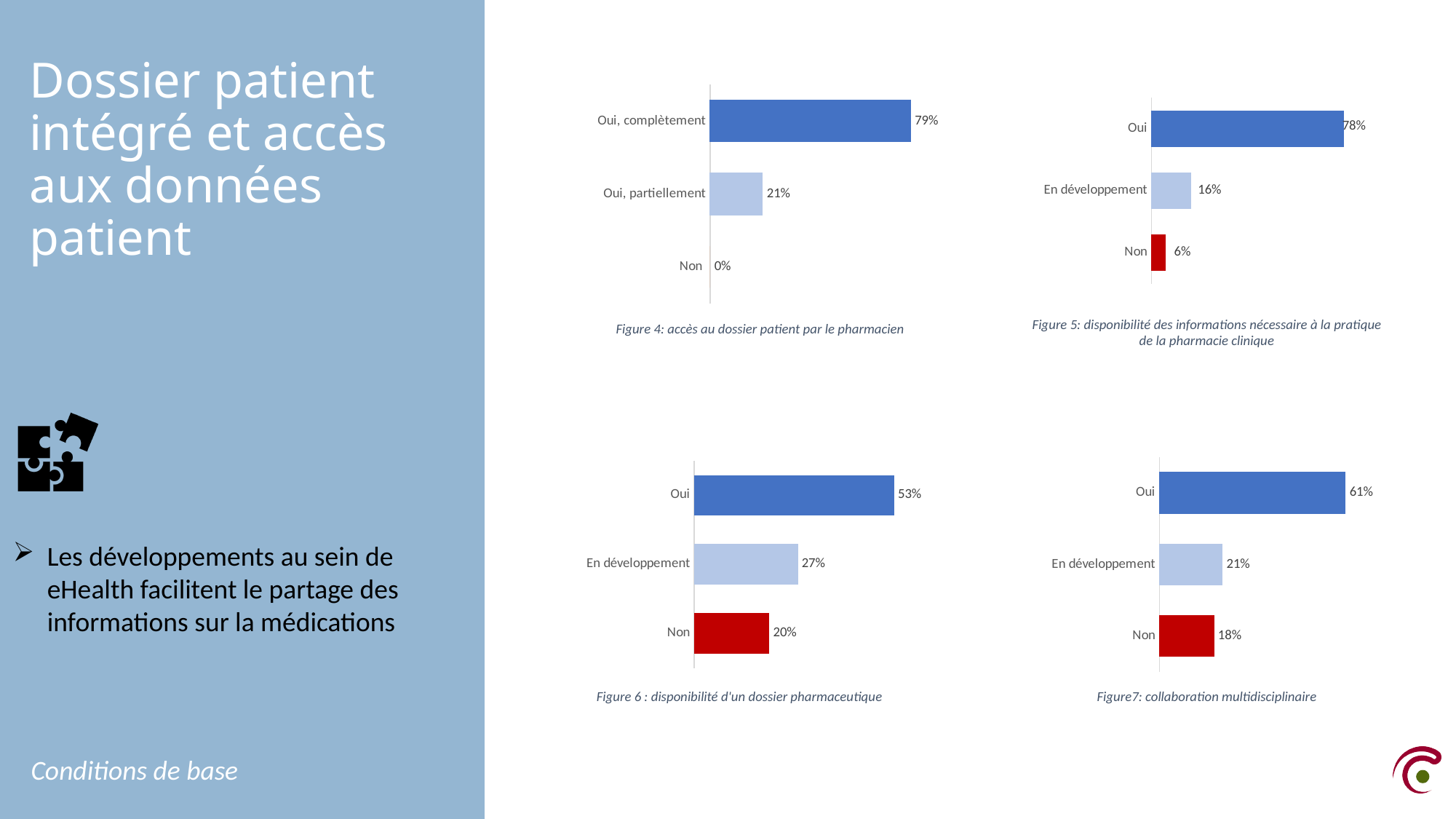
In Figure 6 (disponibilité d'un dossier pharmaceutique), what is the difference between "Oui" and "En développement"? 26% In Figure 5 (disponibilité des informations nécessaire à la pratique de la pharmacie clinique), which category has the lowest value? Non In Figure 4 (accès au dossier patient par le pharmacien), what is the value for "Non"? 0% What kind of chart is Figure 6 (disponibilité d'un dossier pharmaceutique)? Bar chart In Figure 7 (collaboration multidisciplinaire), which category has the highest value? Oui In Figure 4 (accès au dossier patient par le pharmacien), what is the value for "Oui, complètement"? 79% In Figure 6 (disponibilité d'un dossier pharmaceutique), what is the value for "Non"? 20% In Figure 7 (collaboration multidisciplinaire), which is larger, "En développement" or "Non"? En développement In Figure 5 (disponibilité des informations nécessaire à la pratique de la pharmacie clinique), what is the value for "En développement"? 16% In Figure 5 (disponibilité des informations nécessaire à la pratique de la pharmacie clinique), what is the difference between "Oui" and "Non"? 72% How many categories are shown in Figure 4 (accès au dossier patient par le pharmacien)? 3 In Figure 7 (collaboration multidisciplinaire), what is the value for "Oui"? 61%